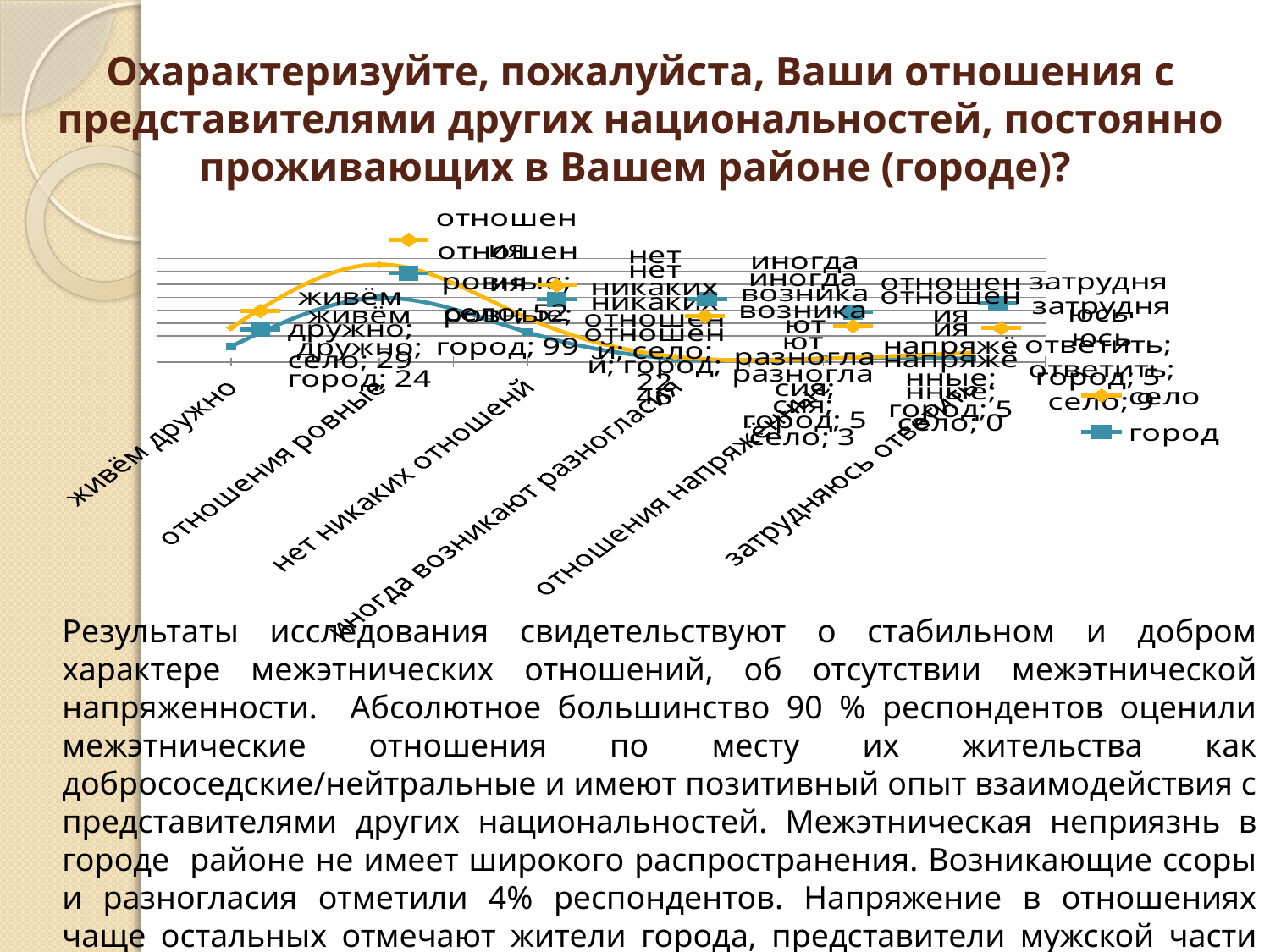
What is the difference between село and город in the category 'живём дружно'? 5 What is the value for село in the category 'живём дружно'? 29 Which category has the highest value for the село series? отношения ровные In the category 'живём дружно', which series has the larger value, село or город? село What is the value for город in the category 'отношения напряжённые'? 5 What are the two series named in the chart legend? село and город What is the value for село in the category 'отношения напряжённые'? 0 How many categories are plotted along the x axis of the chart? 6 What is the value for село in the category 'затрудняюсь ответить'? 9 How many series does the chart legend list? 2 What kind of chart is shown on the slide? line chart What is the value for город in the category 'живём дружно'? 24